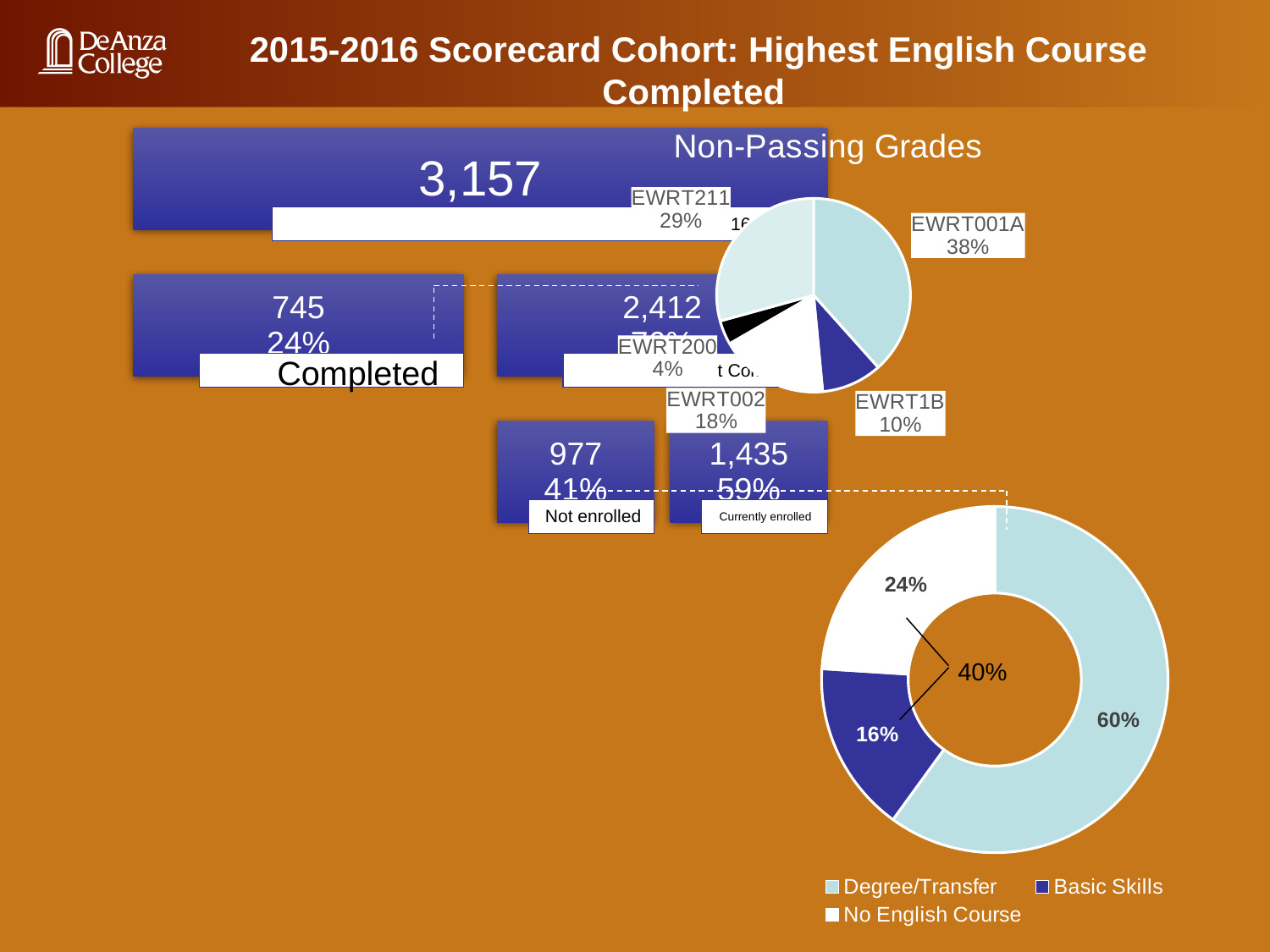
In the donut chart at the bottom right, what is the difference in percentage points between Degree/Transfer and No English Course? 36 percentage points In the Non-Passing Grades pie chart, which labelled course has the largest share? EWRT001A In the Non-Passing Grades pie chart, what percentage is shown for EWRT001A? 38% In the donut chart at the bottom right, what percentage is shown for No English Course? 24% In the donut chart at the bottom right, how many categories does the legend list? 3 In the donut chart at the bottom right, what percentage is shown for Degree/Transfer? 60% In the Non-Passing Grades pie chart, what percentage is shown for EWRT200? 4% In the Non-Passing Grades pie chart, what percentage is shown for EWRT002? 18% In the donut chart at the bottom right, what percentage is shown for Basic Skills? 16% In the Non-Passing Grades pie chart, which labelled course has the smallest share? EWRT200 In the Non-Passing Grades pie chart, which has a larger share, EWRT1B or EWRT002? EWRT002 In the Non-Passing Grades pie chart, what percentage is shown for EWRT211? 29%